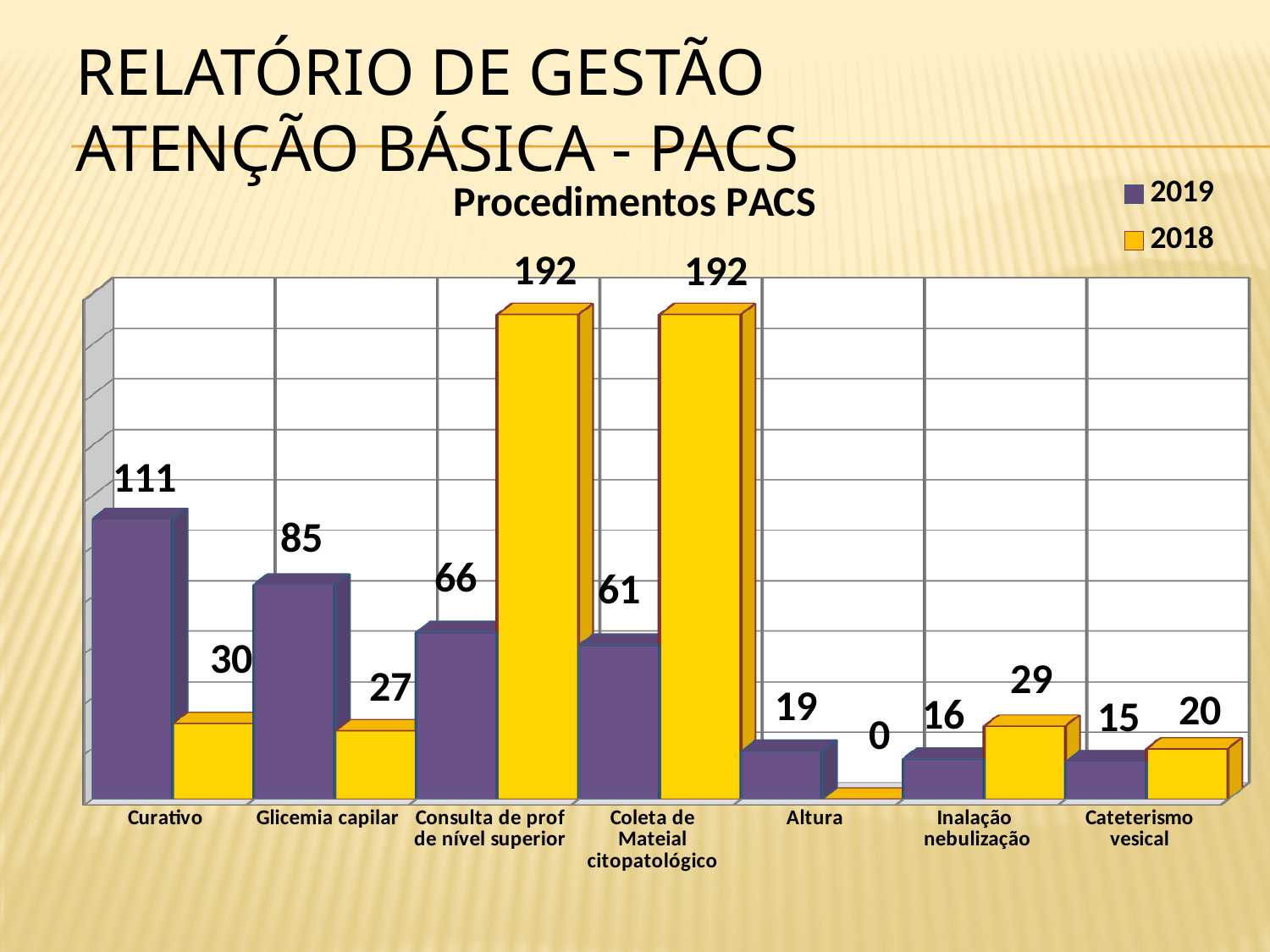
What is the 2018 value for Glicemia capilar? 27 What is the 2019 value for Altura? 19 What is the 2019 value for Curativo in the Procedimentos PACS chart? 111 How many series does the legend list? 2 What is the title of the chart? Procedimentos PACS How many categories are shown on the x axis of the chart? 7 Which category has the lowest 2018 value? Altura What kind of chart is shown on the slide? Bar chart What is the difference between the 2018 and 2019 values for Coleta de Mateial citopatológico? 131 What is the 2018 value for Consulta de prof de nível superior? 192 For Inalação nebulização, which year has the larger value, 2019 or 2018? 2018 Which category has the highest 2019 value? Curativo